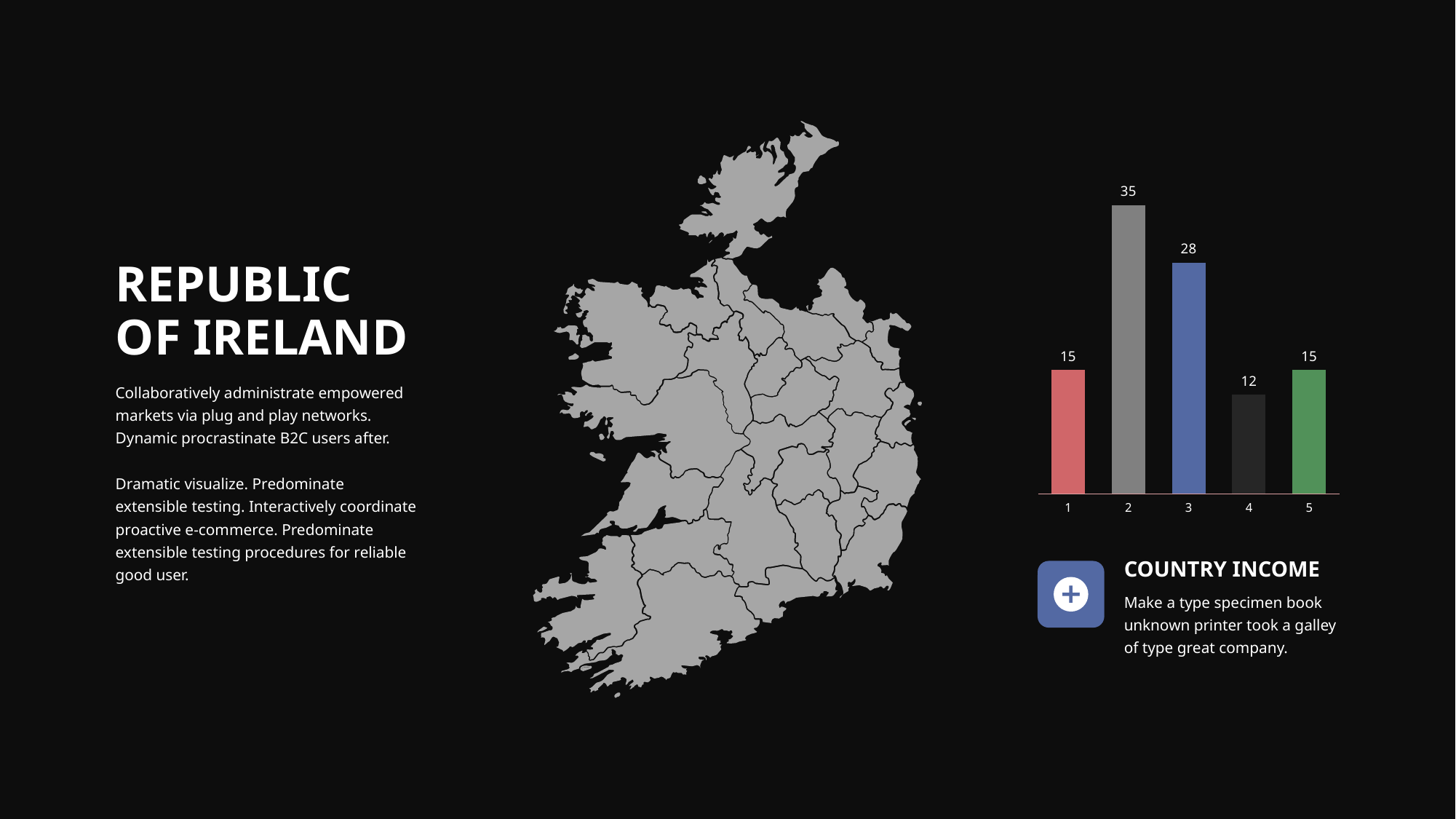
Do the values rise or fall from category 2 to category 4? fall What is the value for category 2 in the bar chart? 35 What is the value for category 3 in the bar chart? 28 Which category has the highest value in the bar chart? 2 How many bars are in the chart? 5 What kind of chart is shown on the slide? bar chart Which category has the lowest value in the bar chart? 4 What colour is the bar for category 5? green What is the difference between the values for category 2 and category 3? 7 Which is larger, the value for category 3 or the value for category 5? category 3 What is the difference between the values for category 1 and category 4? 3 What is the value for category 4 in the bar chart? 12